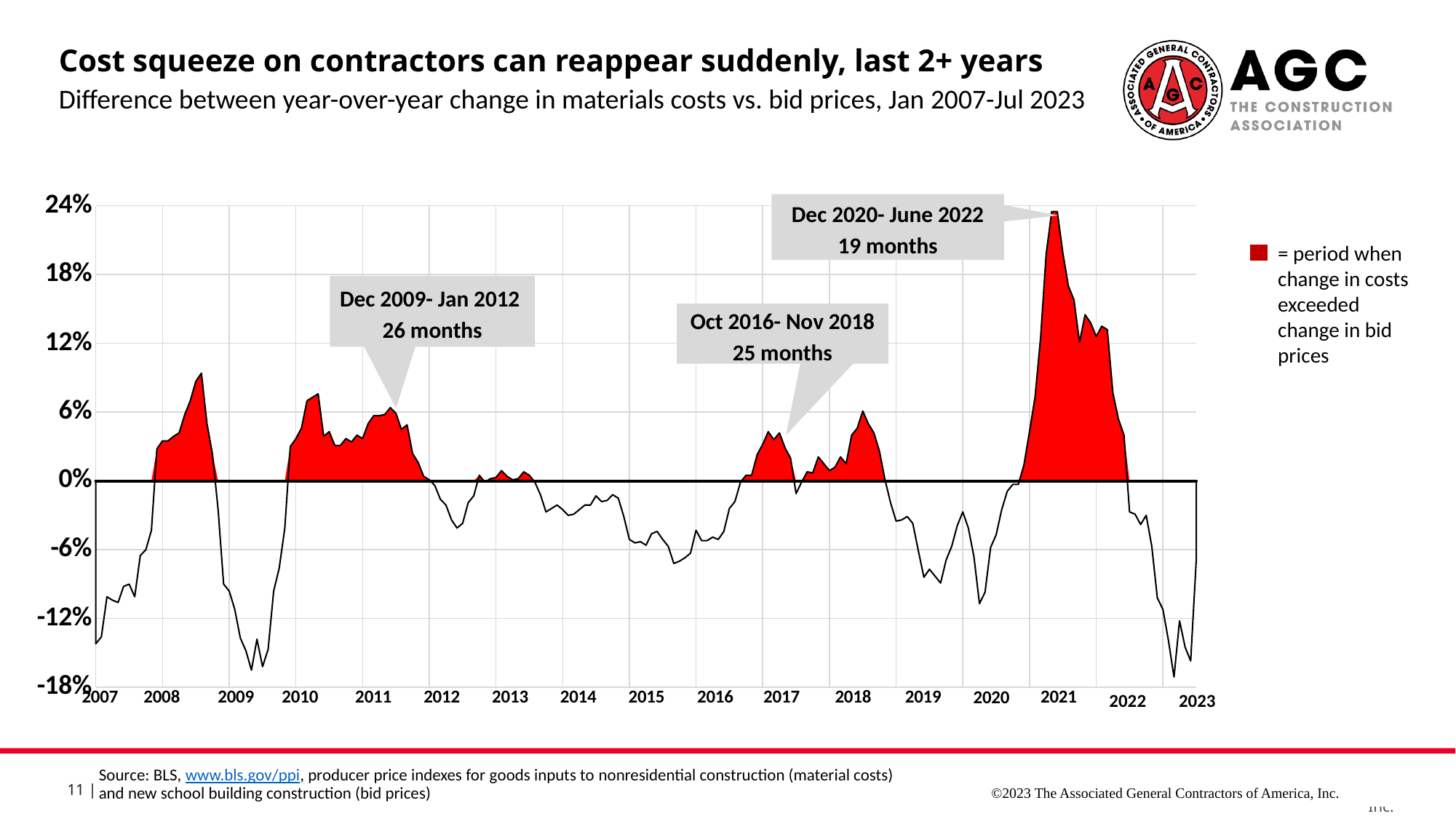
How many months long was the Oct 2016- Nov 2018 period according to the callout? 25 months How many months long was the Dec 2020- June 2022 period according to the callout? 19 months What kind of chart is shown on the slide? line chart How many months long was the Dec 2009- Jan 2012 period according to the callout? 26 months Which labelled period lasted the fewest months? Dec 2020- June 2022 Is the peak value of the line in 2021 greater or less than 18%? greater Which period was longer, Oct 2016- Nov 2018 or Dec 2020- June 2022? Oct 2016- Nov 2018 How many more months did the Dec 2009- Jan 2012 period last than the Dec 2020- June 2022 period? 7 months Which labelled period lasted the most months? Dec 2009- Jan 2012 How many labelled callout periods are marked on the chart? 3 Is the lowest value of the line in 2009 greater or less than -12%? less What does the red shading in the legend represent? period when change in costs exceeded change in bid prices